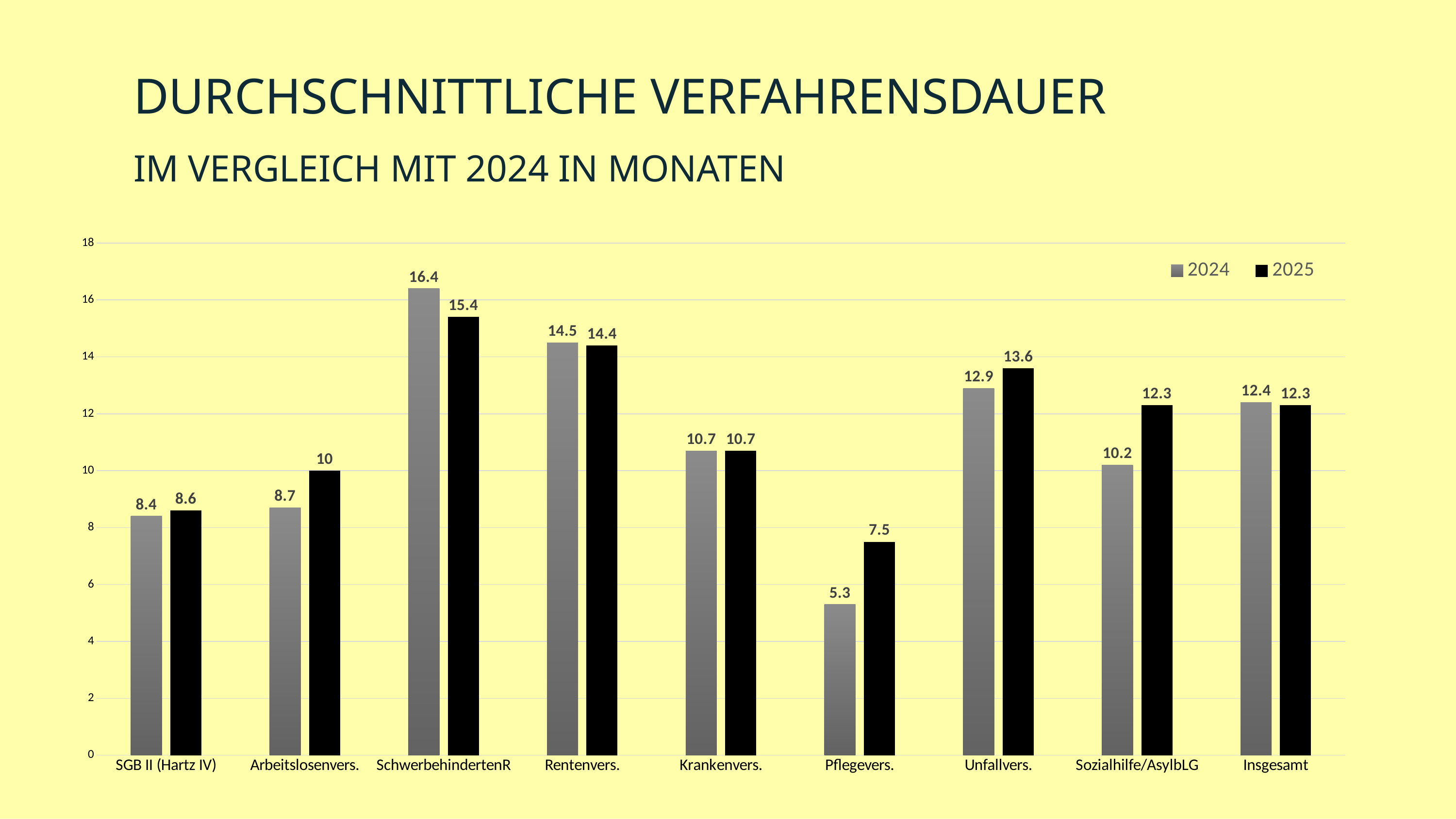
How many categories are shown on the x axis? 9 Which category has the lowest 2025 value? Pflegevers. What is the 2025 value for Arbeitslosenvers.? 10 Which is larger for Unfallvers., the 2024 value or the 2025 value? 2025 Which category has the highest 2024 value? SchwerbehindertenR What is the 2025 value for Pflegevers.? 7.5 What is the difference between the 2024 and 2025 values for Pflegevers.? 2.2 What is the 2024 value for SchwerbehindertenR? 16.4 Is the 2024 value for Sozialhilfe/AsylbLG greater or less than 12? less How many series does the legend list? 2 What kind of chart is shown on the slide? bar chart Which colour represents the 2025 series? black